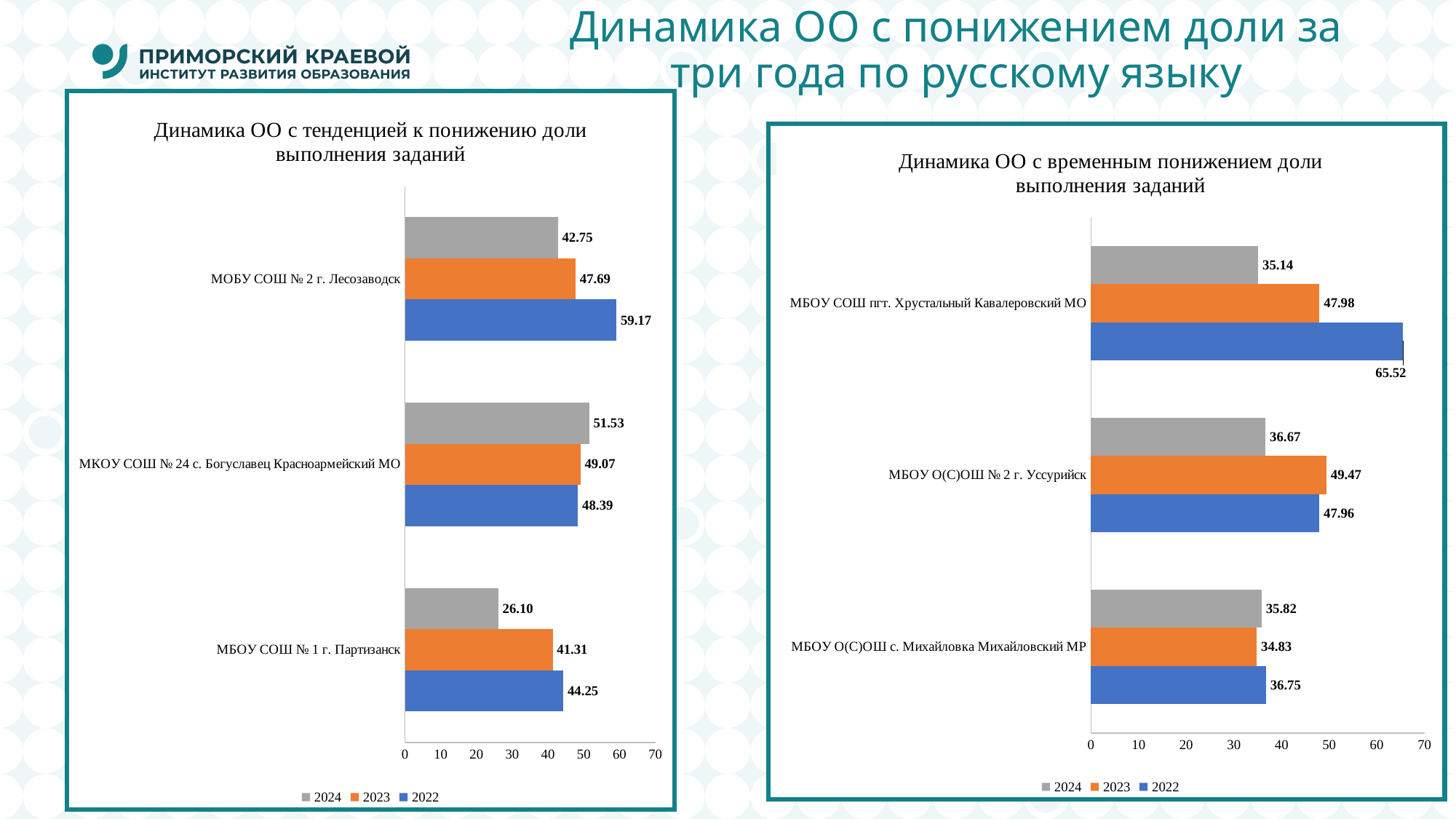
In the left chart, is the 2024 value for МКОУ СОШ № 24 с. Богуславец Красноармейский МО greater or less than 50? greater In the right chart, what is the 2023 value for МБОУ О(С)ОШ с. Михайловка Михайловский МР? 34.83 In the right chart (Динамика ОО с временным понижением доли выполнения заданий), what is the 2022 value for МБОУ СОШ пгт. Хрустальный Кавалеровский МО? 65.52 In the right chart, how many schools are shown? 3 In the left chart, what is the difference between the 2022 and 2024 values for МОБУ СОШ № 2 г. Лесозаводск? 16.42 In the left chart, what is the 2022 value for МБОУ СОШ № 1 г. Партизанск? 44.25 In the left chart (Динамика ОО с тенденцией к понижению доли выполнения заданий), what is the 2024 value for МОБУ СОШ № 2 г. Лесозаводск? 42.75 In the left chart, which school has the lowest 2024 value? МБОУ СОШ № 1 г. Партизанск In the left chart, how many series does the legend list? 3 In the right chart, which school has the highest 2022 value? МБОУ СОШ пгт. Хрустальный Кавалеровский МО What type of chart is the right chart? Bar chart In the right chart, which is larger for МБОУ О(С)ОШ № 2 г. Уссурийск: the 2023 value or the 2024 value? 2023